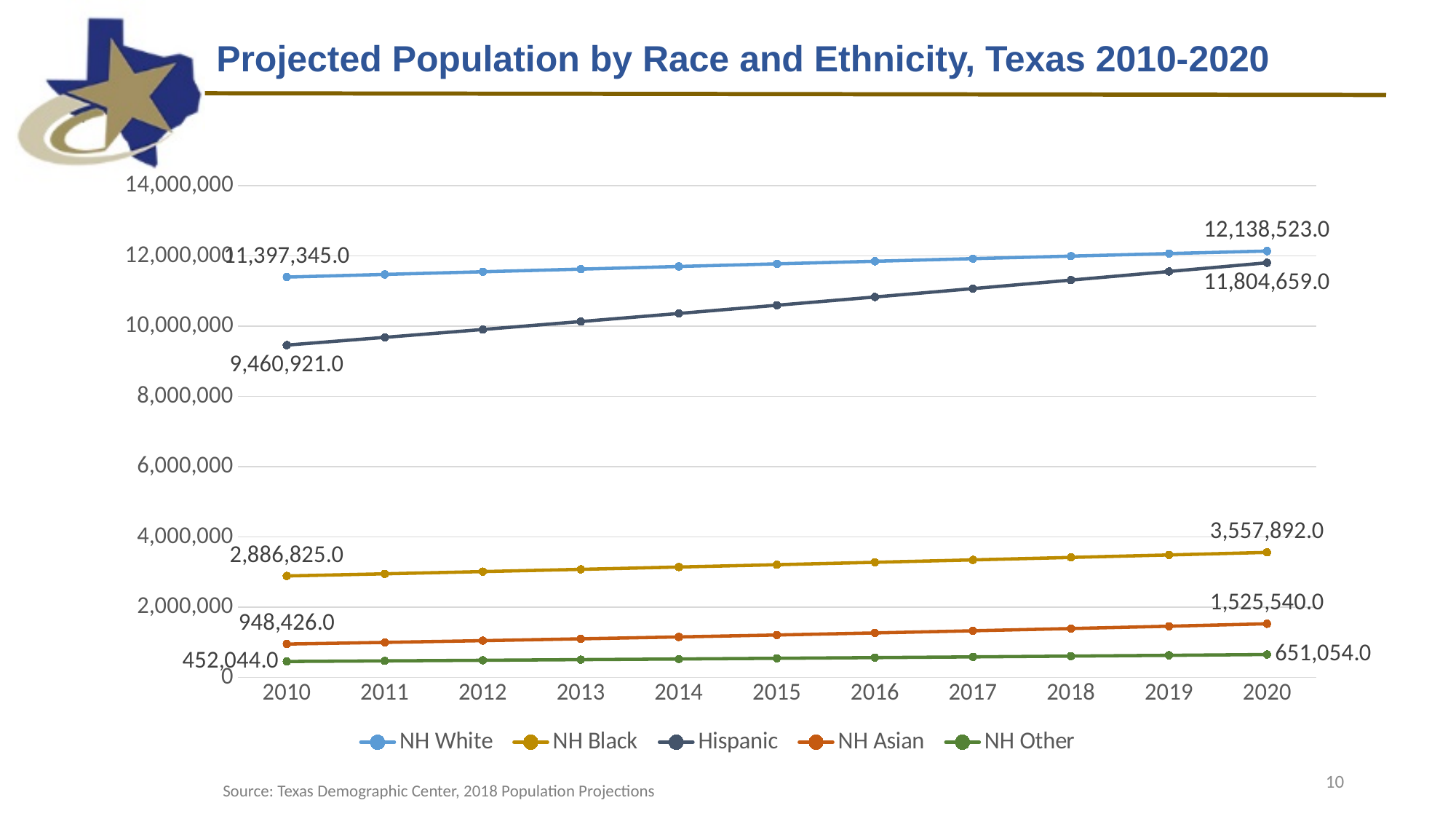
Is the Hispanic population in 2015 greater or less than 10,000,000? greater What is the projected NH Asian population in 2020? 1,525,540.0 Which series has the lowest value in 2020? NH Other Does the NH Black population rise or fall from 2010 to 2020? Rise By how much is the Hispanic population projected to grow from 2010 to 2020? 2,343,738.0 How many years are shown on the x axis? 11 What is the projected NH Other population in 2010? 452,044.0 How many series does the legend list? 5 What is the projected Hispanic population in 2010? 9,460,921.0 Which series has the highest value in 2010? NH White What is the projected NH White population in 2020? 12,138,523.0 What type of chart is shown on the slide? Line chart